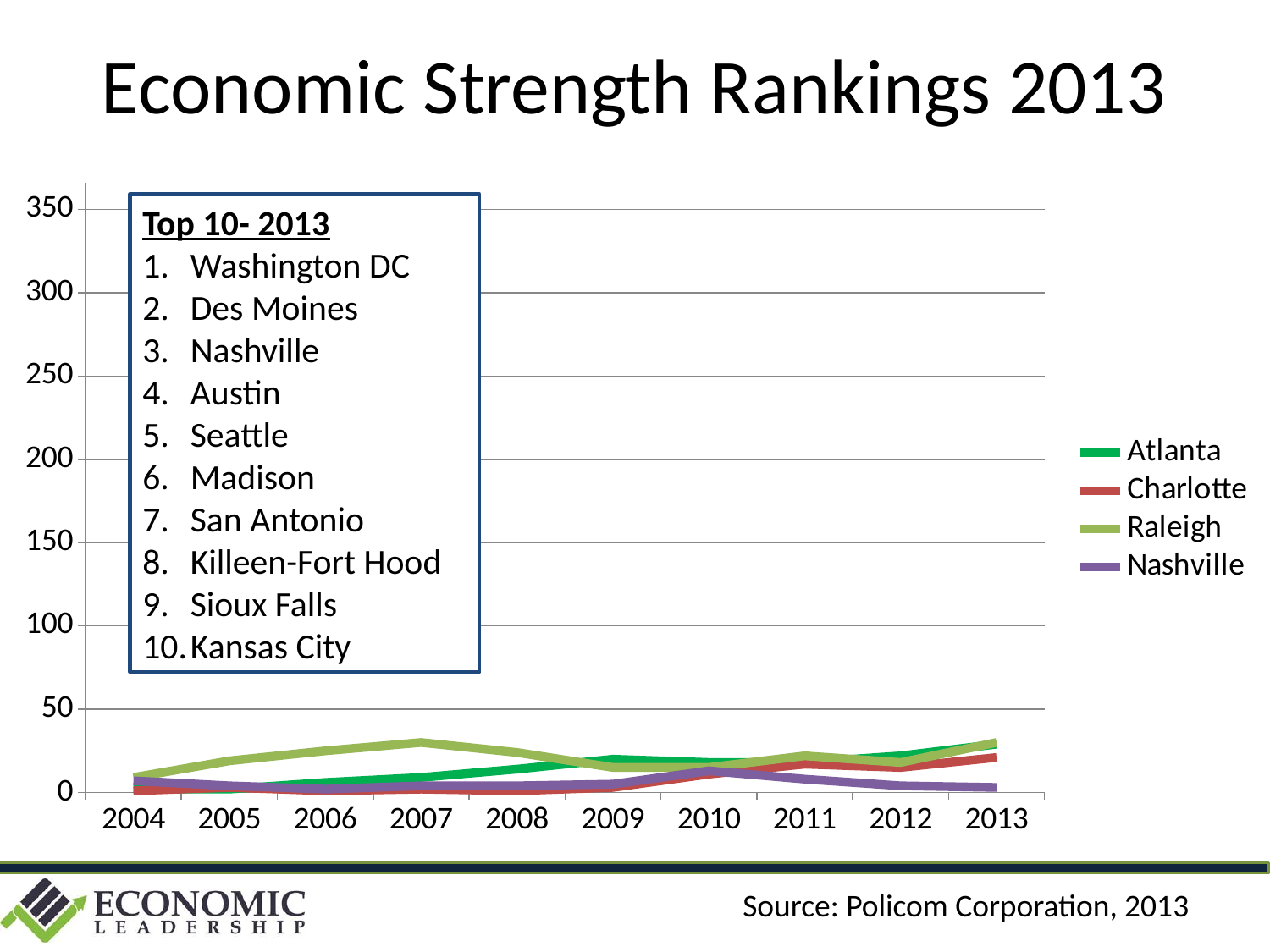
What kind of chart is shown on the slide? line chart How many series does the legend list? 4 What is the title of the slide containing the chart? Economic Strength Rankings 2013 In 2007, which is larger, the value for Raleigh or the value for Charlotte? Raleigh Does the value for Atlanta rise or fall from 2004 to 2013? rise Is the value for Atlanta in 2013 greater or less than 100? less Is the value for Raleigh in 2007 greater or less than 50? less Which series has the lowest value in 2013? Nashville In 2013, which is larger, the value for Raleigh or the value for Nashville? Raleigh How many years are shown along the x axis? 10 Which series has the highest value in 2007? Raleigh Does the value for Nashville rise or fall from 2010 to 2013? fall